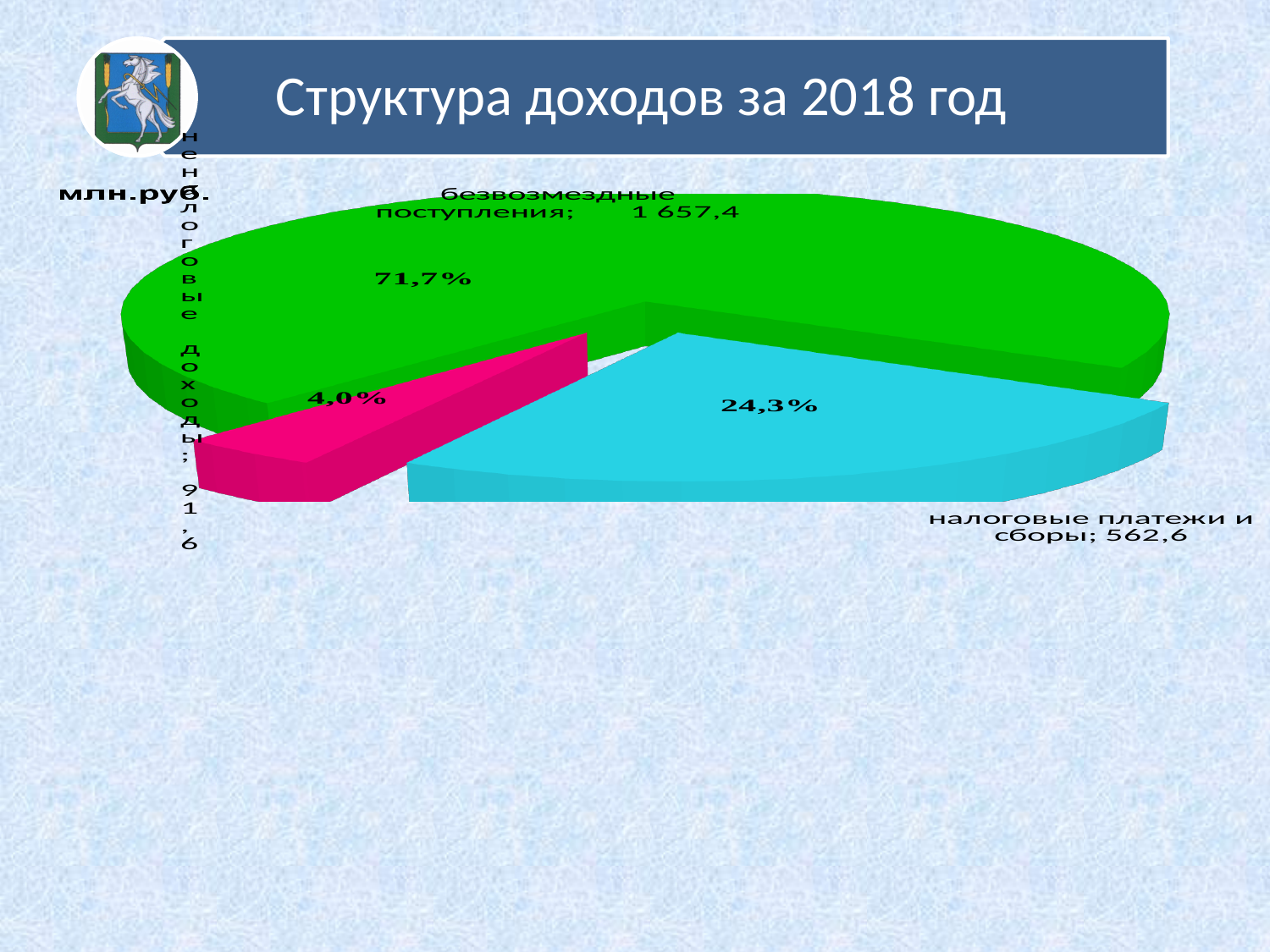
How many slices does the pie chart have? 3 What is the value for неналоговые доходы? 91,6 Which is larger, налоговые платежи и сборы or неналоговые доходы? налоговые платежи и сборы Which category has the largest slice? безвозмездные поступления What share of the pie does неналоговые доходы take? 4,0% What share of the pie does налоговые платежи и сборы take? 24,3% What share of the pie does безвозмездные поступления take? 71,7% What is the value for налоговые платежи и сборы? 562,6 What is the value for безвозмездные поступления? 1 657,4 What is the title of the chart? Структура доходов за 2018 год Which category has the smallest slice? неналоговые доходы What kind of chart is shown on the slide? pie chart